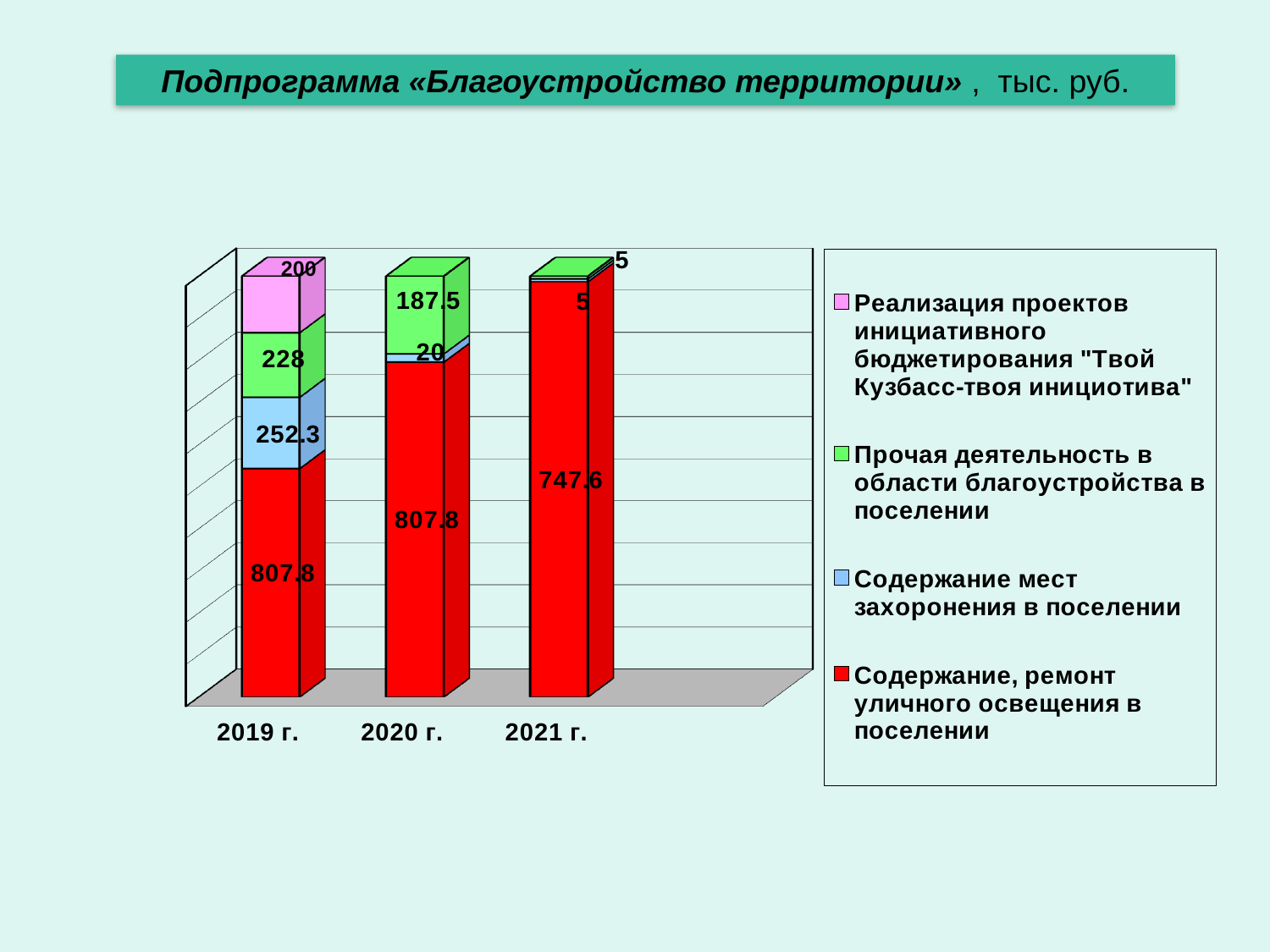
What is the value for "Содержание мест захоронения в поселении" in 2019 г.? 252.3 What is the value for "Содержание, ремонт уличного освещения в поселении" in 2021 г.? 747.6 What type of chart is shown on the slide? Stacked bar chart What is the difference between the "Прочая деятельность в области благоустройства в поселении" values for 2019 г. and 2020 г.? 40.5 Does the total of the stacked bars rise or fall from 2019 г. to 2021 г.? Fall How many years (categories) are shown on the x axis? 3 What is the total of the stacked bar for 2019 г.? 1488.1 What is the value for "Реализация проектов инициативного бюджетирования" in 2019 г.? 200 How many series does the legend list? 4 Which year has the highest total stacked bar? 2019 г. What is the value for "Прочая деятельность в области благоустройства в поселении" in 2020 г.? 187.5 What is the total of the stacked bar for 2021 г.? 757.6